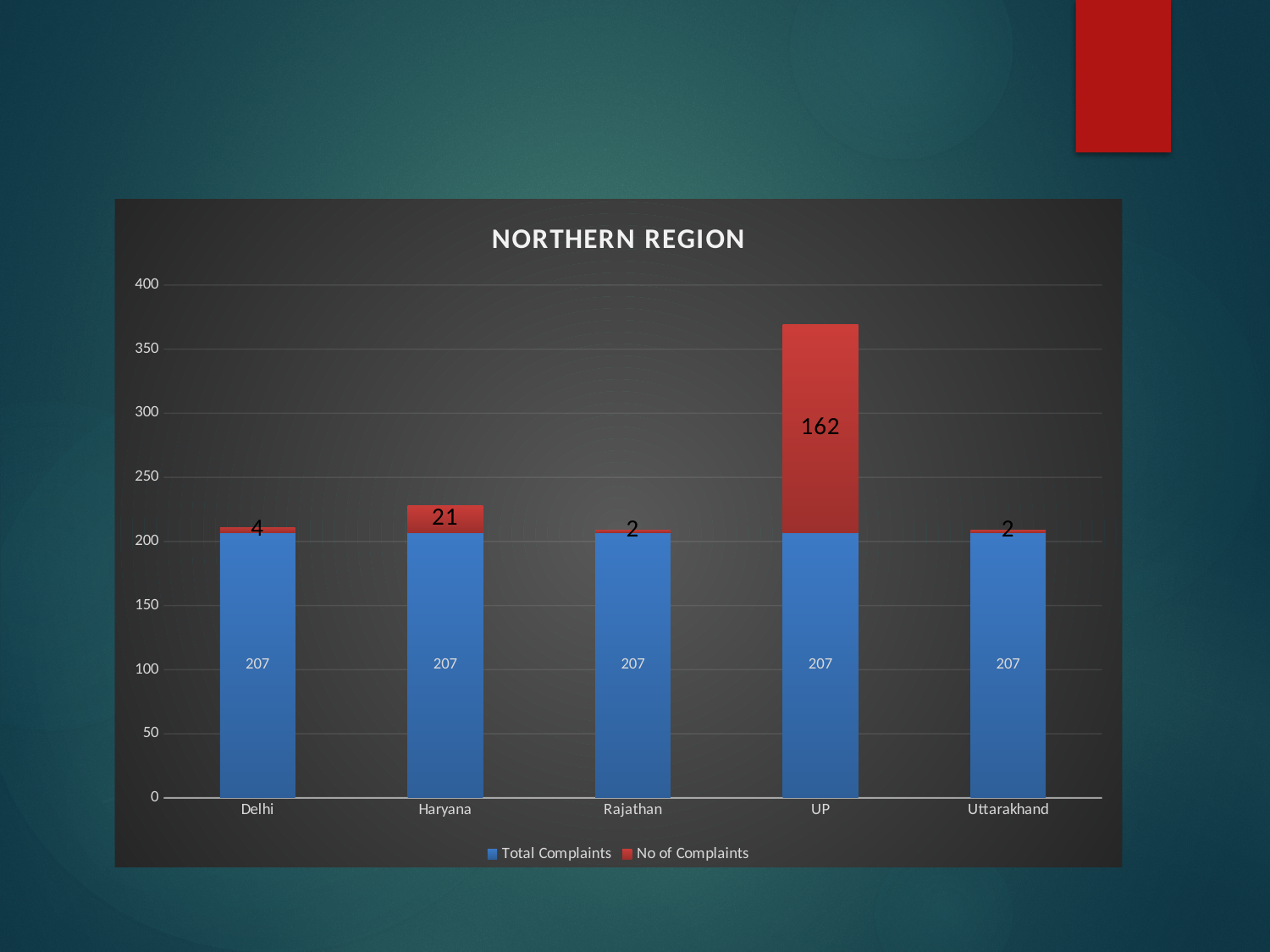
What is the No of Complaints value for UP? 162 Which is larger, the No of Complaints for Delhi or for Haryana? Haryana Is the total stacked bar for Haryana greater or less than 250? less What is the difference between the No of Complaints for UP and Haryana? 141 What kind of chart is shown on the slide? Stacked bar chart Which category has the highest No of Complaints? UP What is the No of Complaints value for Haryana? 21 What is the Total Complaints value for Delhi? 207 What is the title of the chart? NORTHERN REGION What is the total height of the stacked bar for UP? 369 How many categories are shown on the x axis? 5 How many series does the legend list? 2